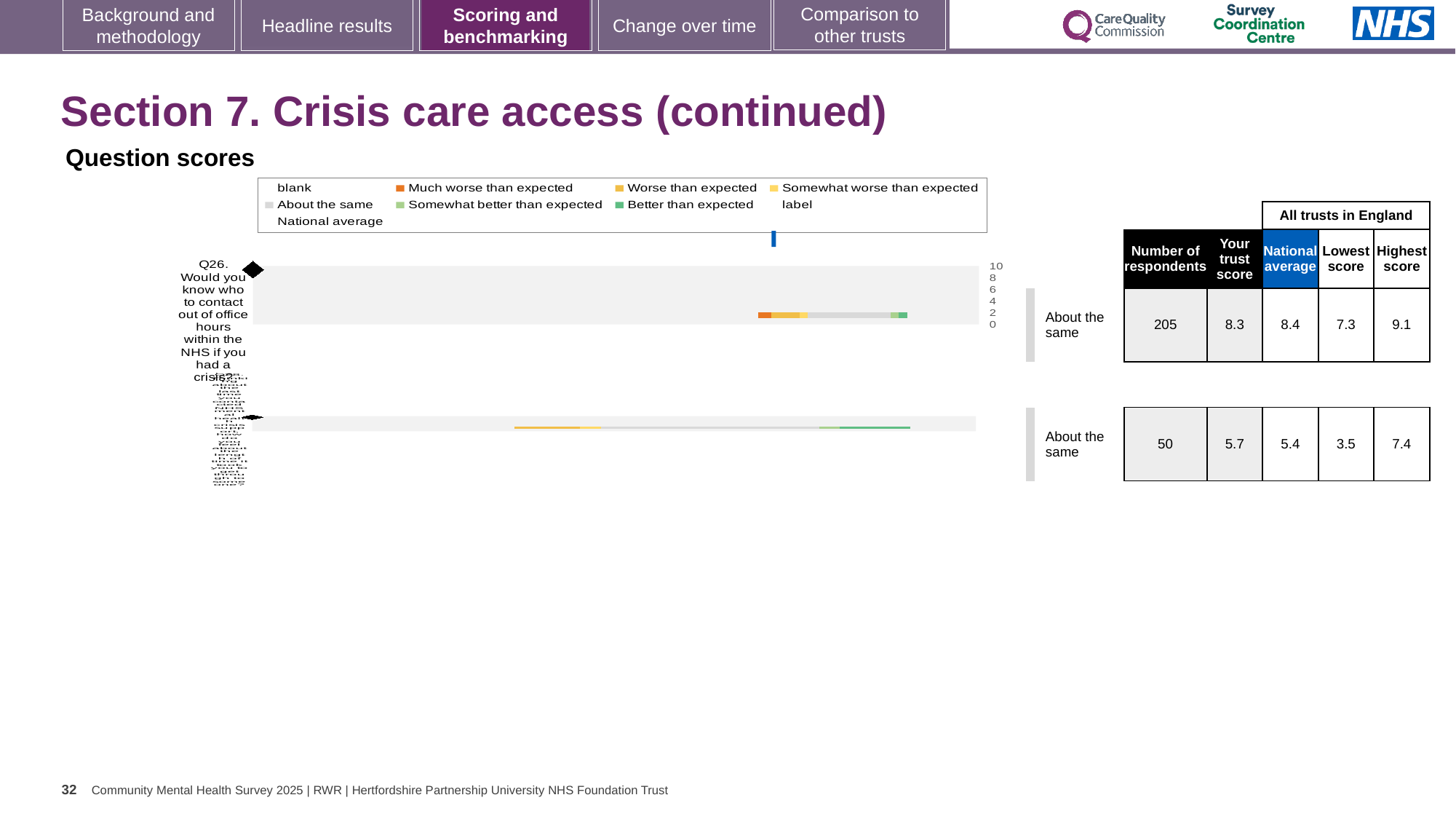
What is the highest score among all trusts in England for Q26? 9.1 For Q26, what is the difference between the highest and lowest scores among all trusts in England? 1.8 How many question rows are plotted in the question scores chart? 2 What is the trust's score for Q26 (Would you know who to contact out of office hours within the NHS if you had a crisis?)? 8.3 For Q26, what is the difference between the national average and the trust's score? 0.1 For Q26, which is larger: the trust's score or the national average? the national average In the legend, what colour represents 'Much worse than expected'? orange How is the trust's result for Q26 categorised relative to expectations, according to the label beside the chart? About the same What is the number of respondents for Q26 (Would you know who to contact out of office hours within the NHS if you had a crisis?)? 205 What kind of chart is used to show the question scores on this slide? bar chart What is the lowest score among all trusts in England for Q26? 7.3 What is the national average score for Q26 (Would you know who to contact out of office hours within the NHS if you had a crisis?)? 8.4